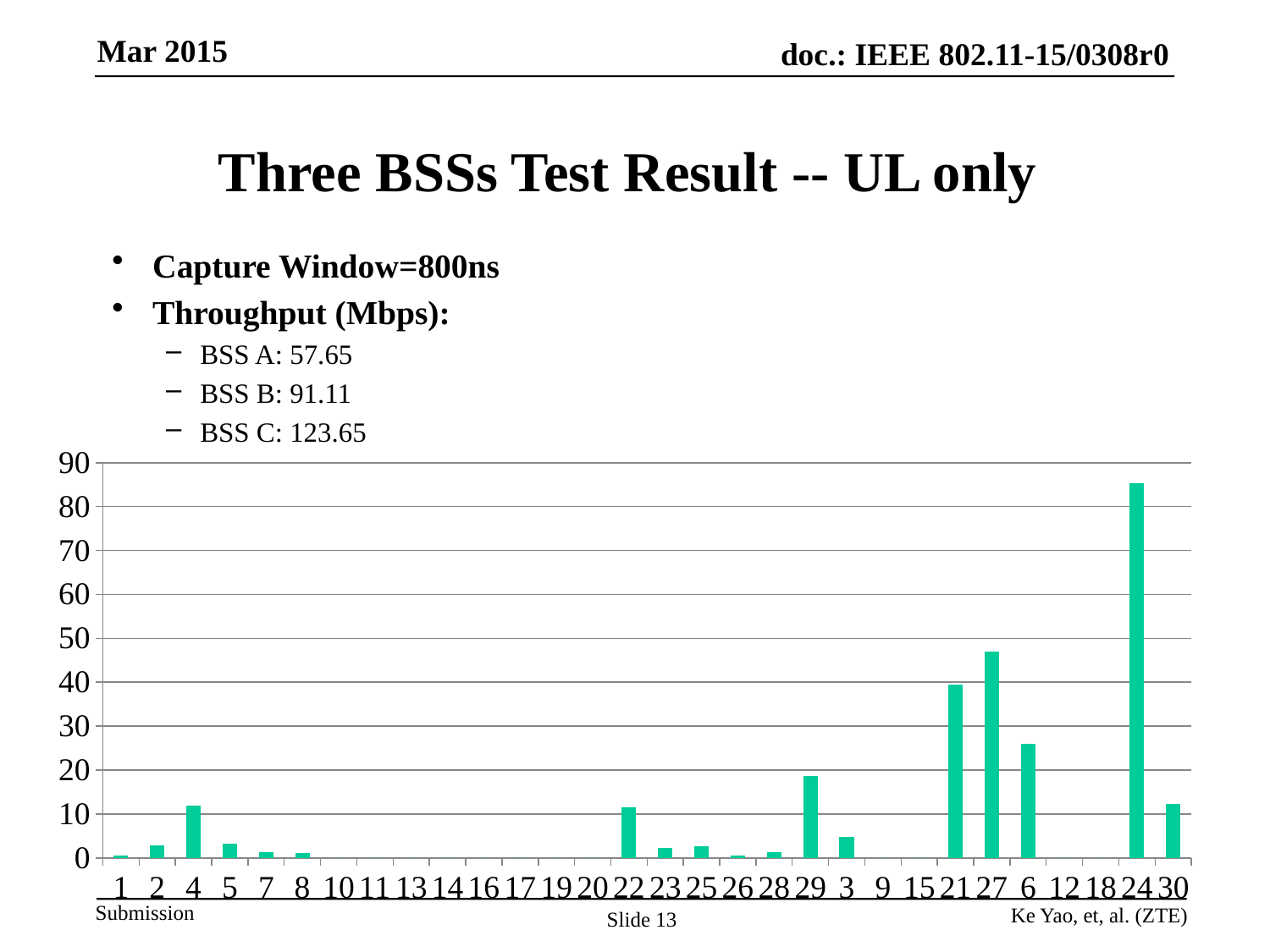
Which has the larger value, category 29 or category 3? 29 Is the value for category 23 greater or less than 10? less Is the value for category 6 greater or less than 20? greater What colour are the bars in the chart? green Which has the larger value, category 27 or category 21? 27 How many categories are shown along the x axis of the chart? 30 Which category has the tallest bar in the chart? 24 Is the value for category 24 greater or less than 80? greater What kind of chart is shown on the slide? bar chart What is the highest value shown on the y axis of the chart? 90